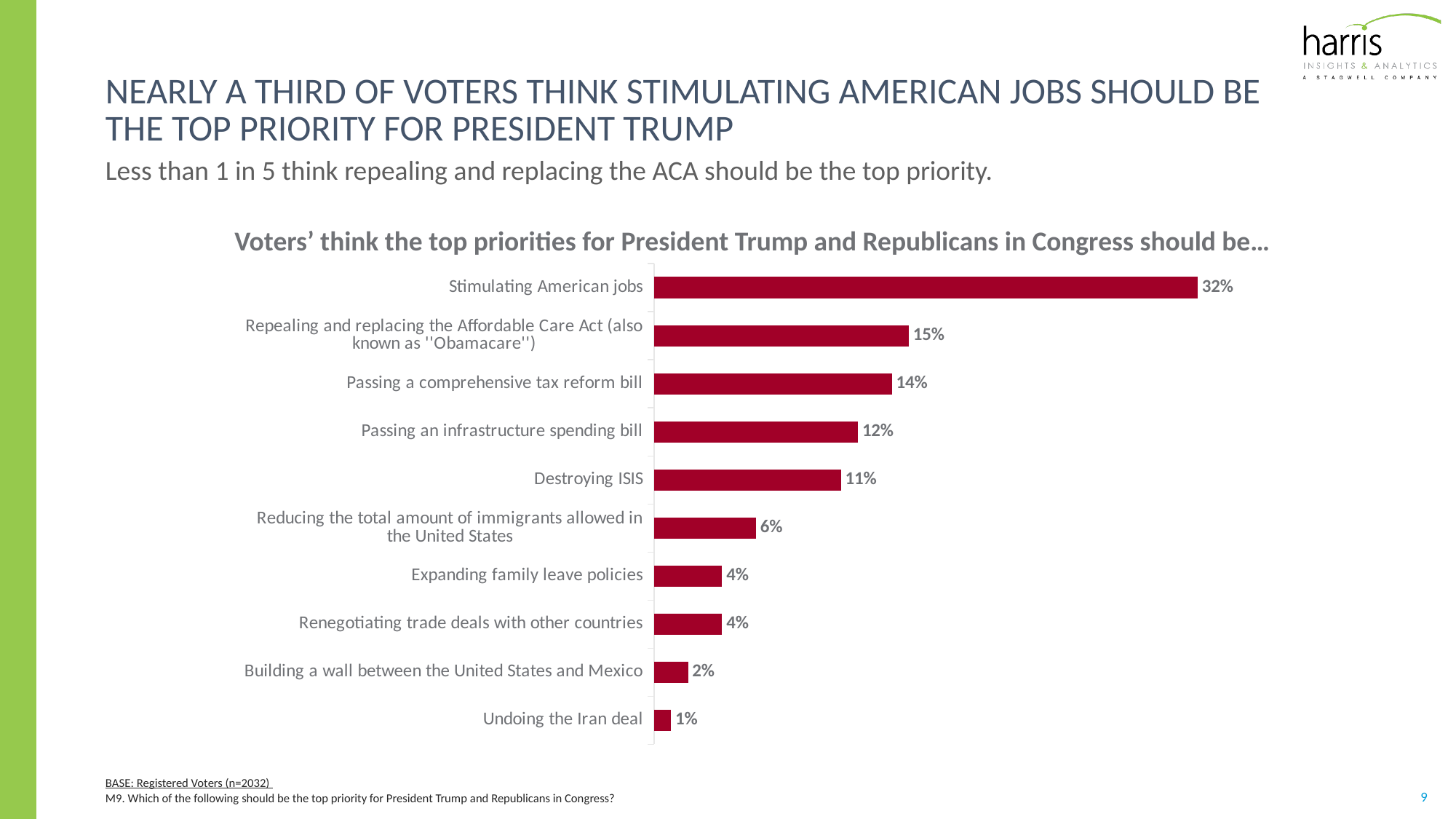
What is the value for building a wall between the United States and Mexico? 2% What percentage chose destroying ISIS as the top priority? 11% What is the value for passing a comprehensive tax reform bill? 14% What kind of chart is shown on the slide? Bar chart Which is larger: the value for passing a comprehensive tax reform bill or the value for passing an infrastructure spending bill? Passing a comprehensive tax reform bill What is the difference between the values for stimulating American jobs and repealing and replacing the Affordable Care Act? 17% How many priorities are shown in the chart? 10 What is the difference between passing an infrastructure spending bill and reducing the total amount of immigrants allowed in the United States? 6% Which priority has the lowest value? Undoing the Iran deal Which priority has the highest value? Stimulating American jobs What is the title of the chart? Voters' think the top priorities for President Trump and Republicans in Congress should be... What percentage of voters think stimulating American jobs should be the top priority? 32%